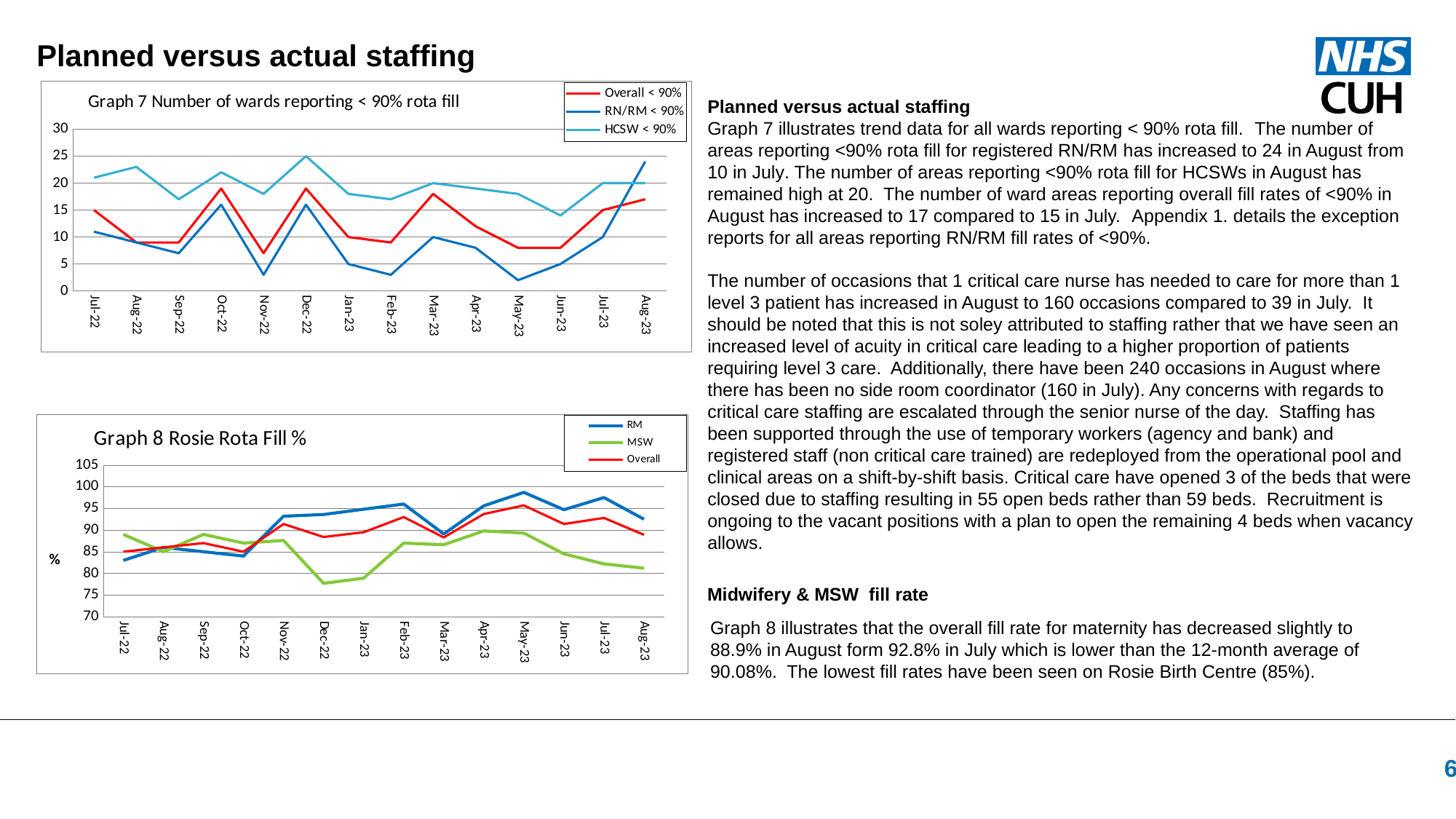
In Graph 7 Number of wards reporting < 90% rota fill, is the RN/RM < 90% value for Aug-23 greater or less than 20? greater How many series does the legend of Graph 8 Rosie Rota Fill % list? 3 How many months are plotted along the x axis of Graph 7 Number of wards reporting < 90% rota fill? 14 In Graph 8 Rosie Rota Fill %, is the MSW value for Dec-22 greater or less than 80? less In Graph 8 Rosie Rota Fill %, in which month is the MSW series lowest? Dec-22 What kind of chart is Graph 7 Number of wards reporting < 90% rota fill? Line chart In Graph 7 Number of wards reporting < 90% rota fill, which is larger at Aug-23: RN/RM < 90% or Overall < 90%? RN/RM < 90% In Graph 8 Rosie Rota Fill %, does the MSW series rise or fall from May-23 to Aug-23? Fall In Graph 7 Number of wards reporting < 90% rota fill, in which month is the RN/RM < 90% series highest? Aug-23 In Graph 7 Number of wards reporting < 90% rota fill, what is the HCSW < 90% value for Jul-23? 20 In Graph 7 Number of wards reporting < 90% rota fill, in which month is the HCSW < 90% series highest? Dec-22 How many series does the legend of Graph 7 Number of wards reporting < 90% rota fill list? 3